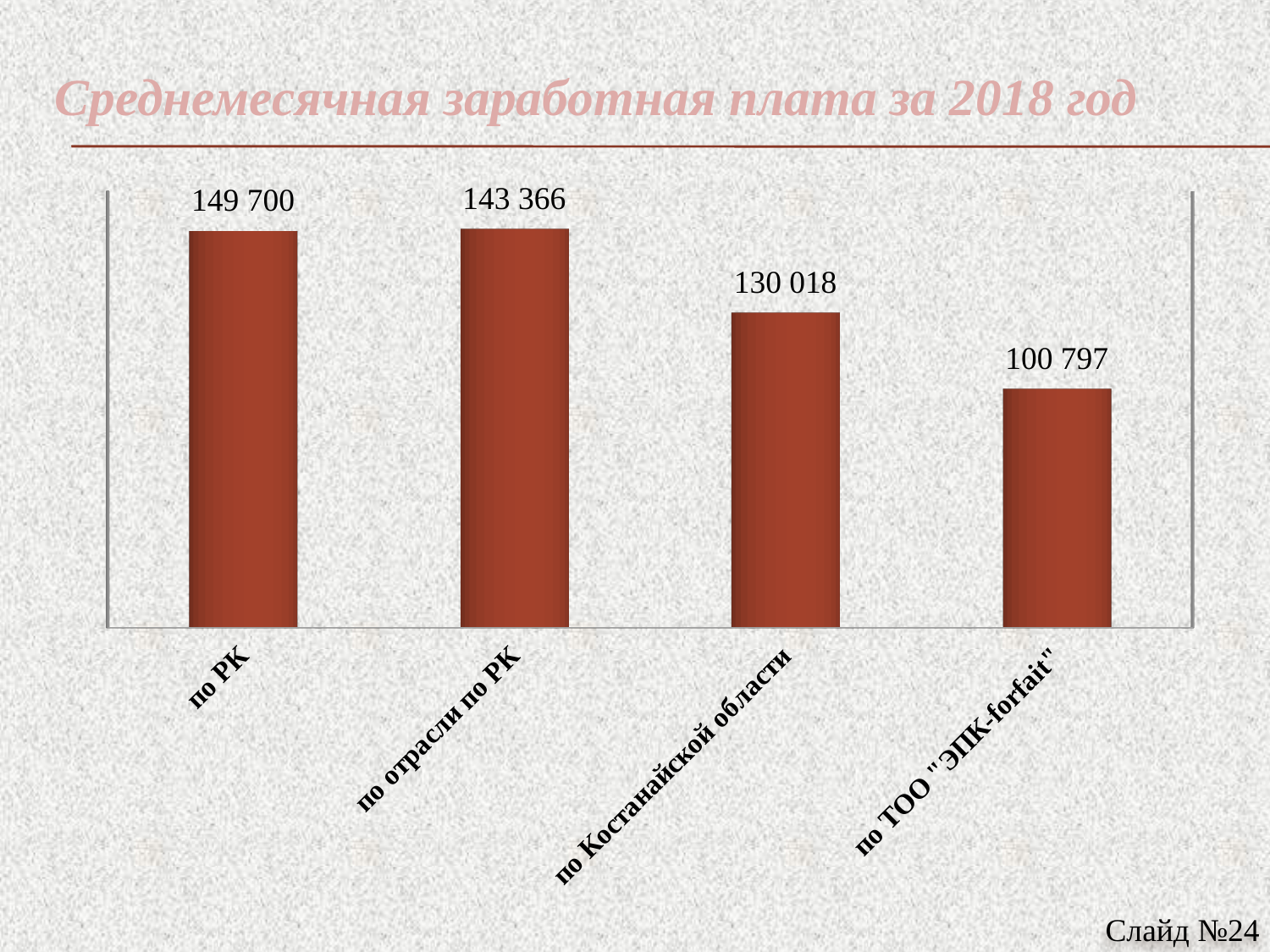
What is the value for "по ТОО "ЭПК-forfait""? 100 797 What is the value for "по отрасли по РК"? 143 366 What is the value for "по Костанайской области"? 130 018 Which is larger, the value for "по Костанайской области" or the value for "по ТОО "ЭПК-forfait""? по Костанайской области What kind of chart is shown on the slide? Bar chart What is the difference between the values for "по отрасли по РК" and "по Костанайской области"? 13 348 Do the values rise or fall from left to right across the categories? Fall Which category has the lowest value? по ТОО "ЭПК-forfait" What is the difference between the values for "по РК" and "по ТОО "ЭПК-forfait""? 48 903 What is the value for "по РК"? 149 700 How many categories are shown in the chart? 4 Which category has the highest value? по РК